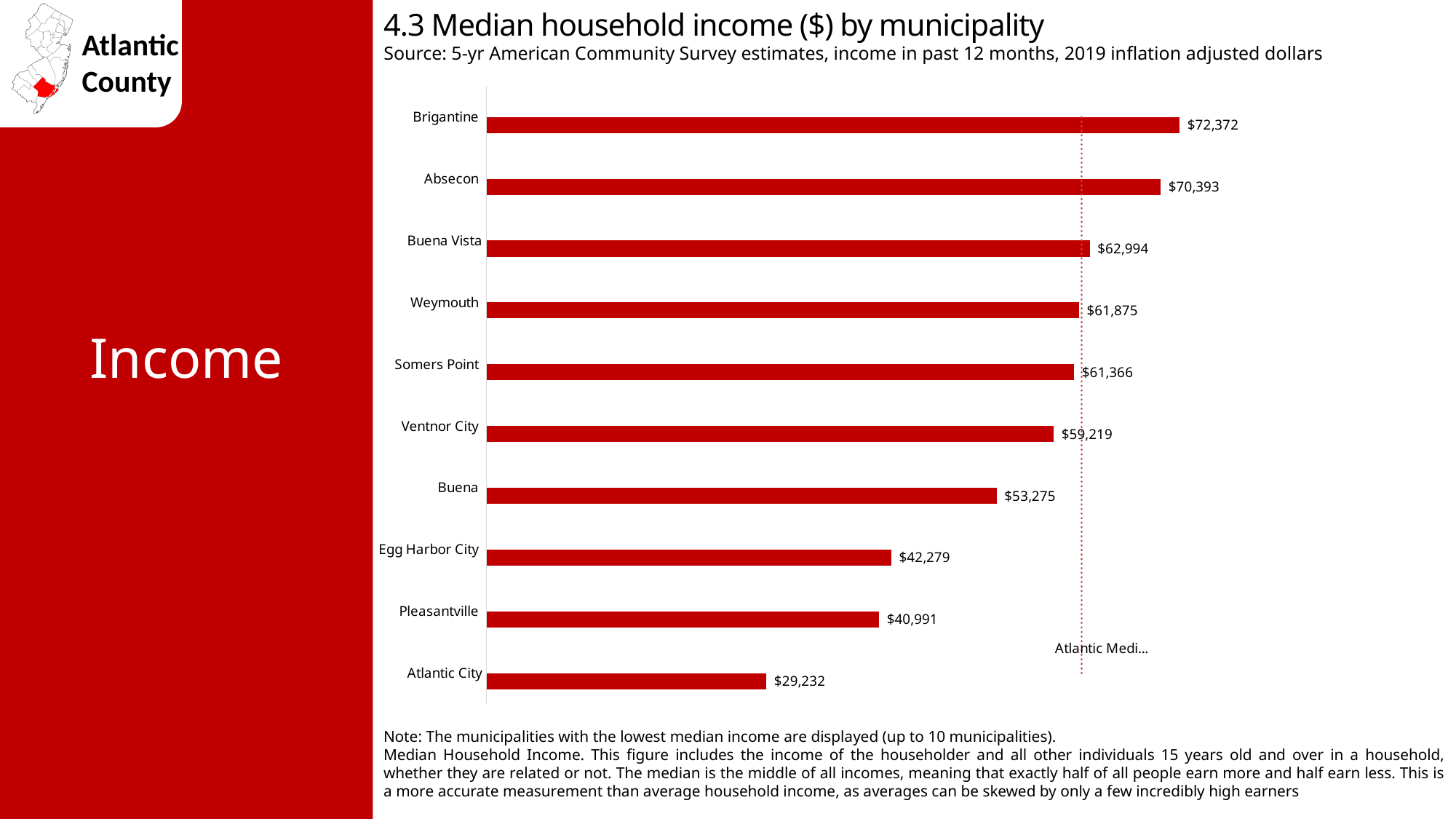
Which municipality has the lowest median household income shown on the chart? Atlantic City What kind of chart is used to show median household income by municipality? Bar chart What is the median household income for Egg Harbor City? $42,279 What is the median household income for Somers Point? $61,366 What is the difference in median household income between Brigantine and Absecon? $1,979 How many municipalities are shown on the chart? 10 Which municipality has the highest median household income shown on the chart? Brigantine What is the median household income for Brigantine? $72,372 What is the difference in median household income between Pleasantville and Atlantic City? $11,759 What is the title of the chart? 4.3 Median household income ($) by municipality Which has a higher median household income, Buena or Ventnor City? Ventnor City What is the median household income for Atlantic City? $29,232